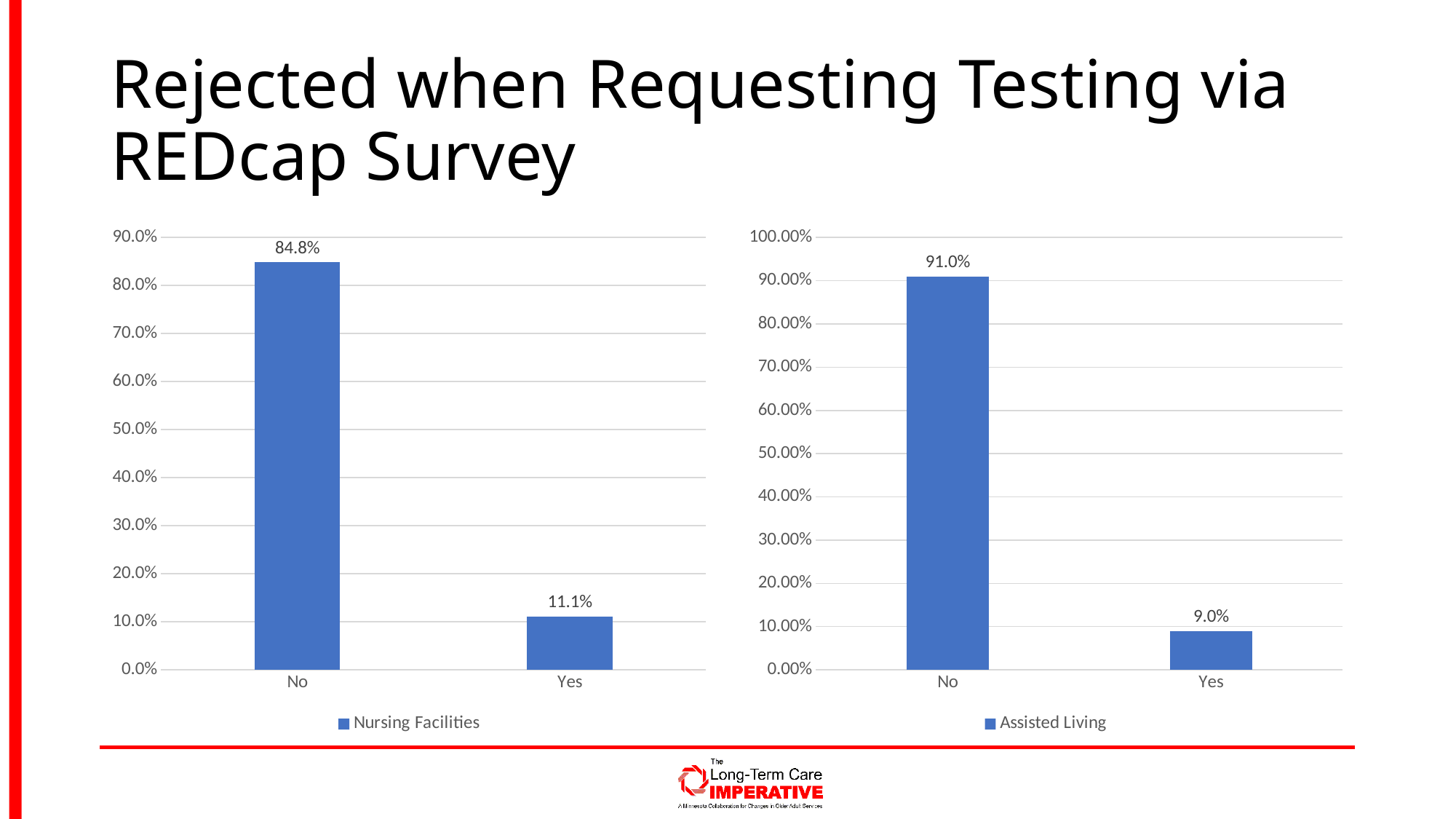
In the left chart (Nursing Facilities), which category has the highest value? No In the right chart (Assisted Living), what is the value for Yes? 9.0% How many categories are shown on the x axis of the left chart (Nursing Facilities)? 2 In the right chart (Assisted Living), which category has the lowest value? Yes What series name does the legend of the left chart show? Nursing Facilities In the left chart (Nursing Facilities), what is the value for Yes? 11.1% In the right chart (Assisted Living), what is the value for No? 91.0% In the right chart (Assisted Living), what is the difference between the No and Yes values? 82.0% In the left chart (Nursing Facilities), what is the value for No? 84.8% What kind of chart is the right chart (Assisted Living)? Bar chart In the left chart (Nursing Facilities), what is the difference between the No and Yes values? 73.7% Which is larger: the No value in the left chart (Nursing Facilities) or the No value in the right chart (Assisted Living)? Assisted Living